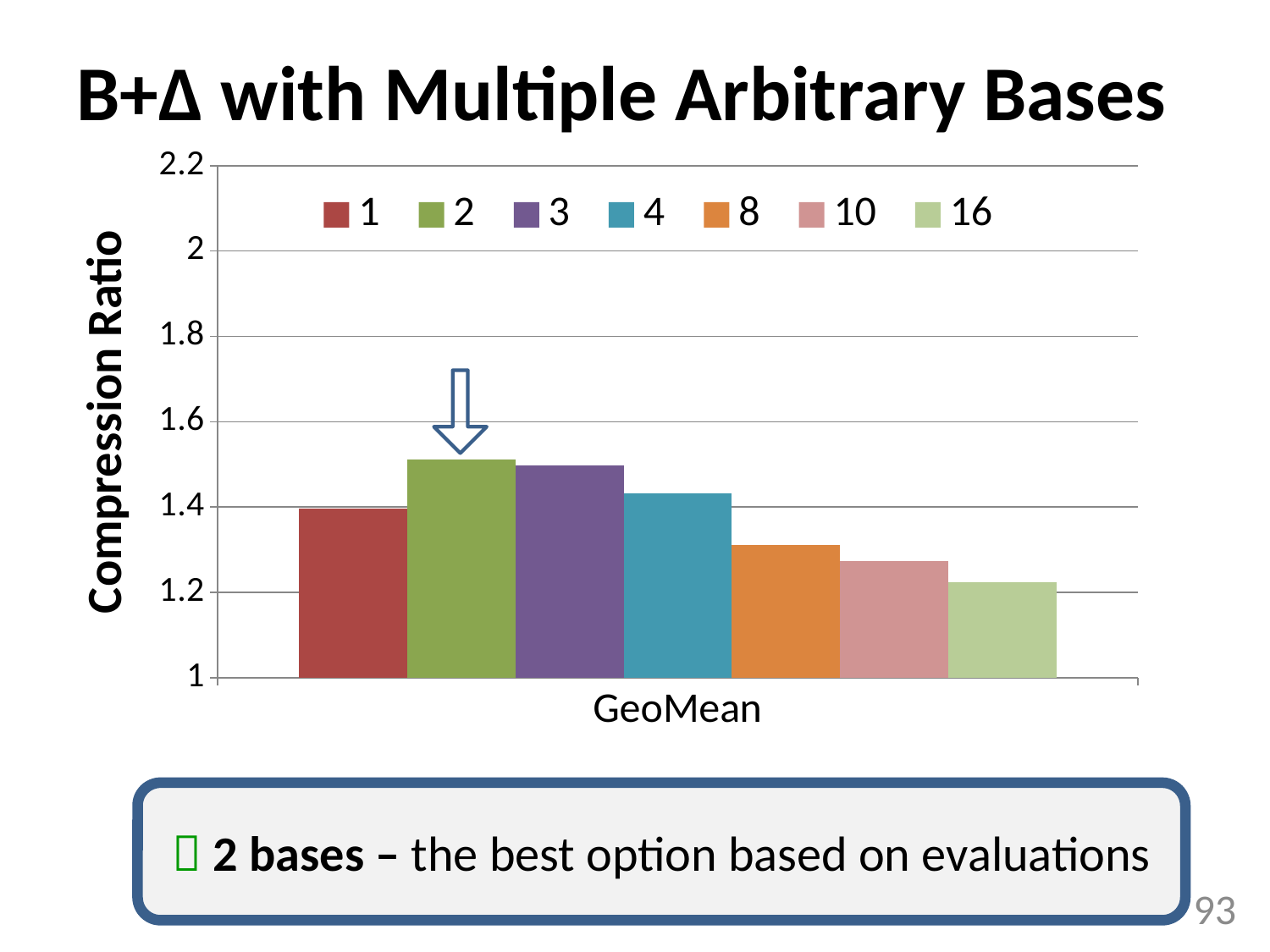
How many categories are shown on the x axis? 1 Which has the larger compression ratio, series 2 or series 8? 2 Which series has the lowest compression ratio for GeoMean? 16 What kind of chart is shown on the slide? bar chart Which series has the highest compression ratio for GeoMean? 2 Which has the larger compression ratio, series 4 or series 16? 4 Is the compression ratio for series 2 greater or less than 1.4? greater Is the compression ratio for series 10 greater or less than 1.4? less How many series does the legend list? 7 Is the compression ratio for series 8 greater or less than 1.4? less What is the label on the y axis? Compression Ratio From series 2 to series 16, do the bars rise or fall? fall